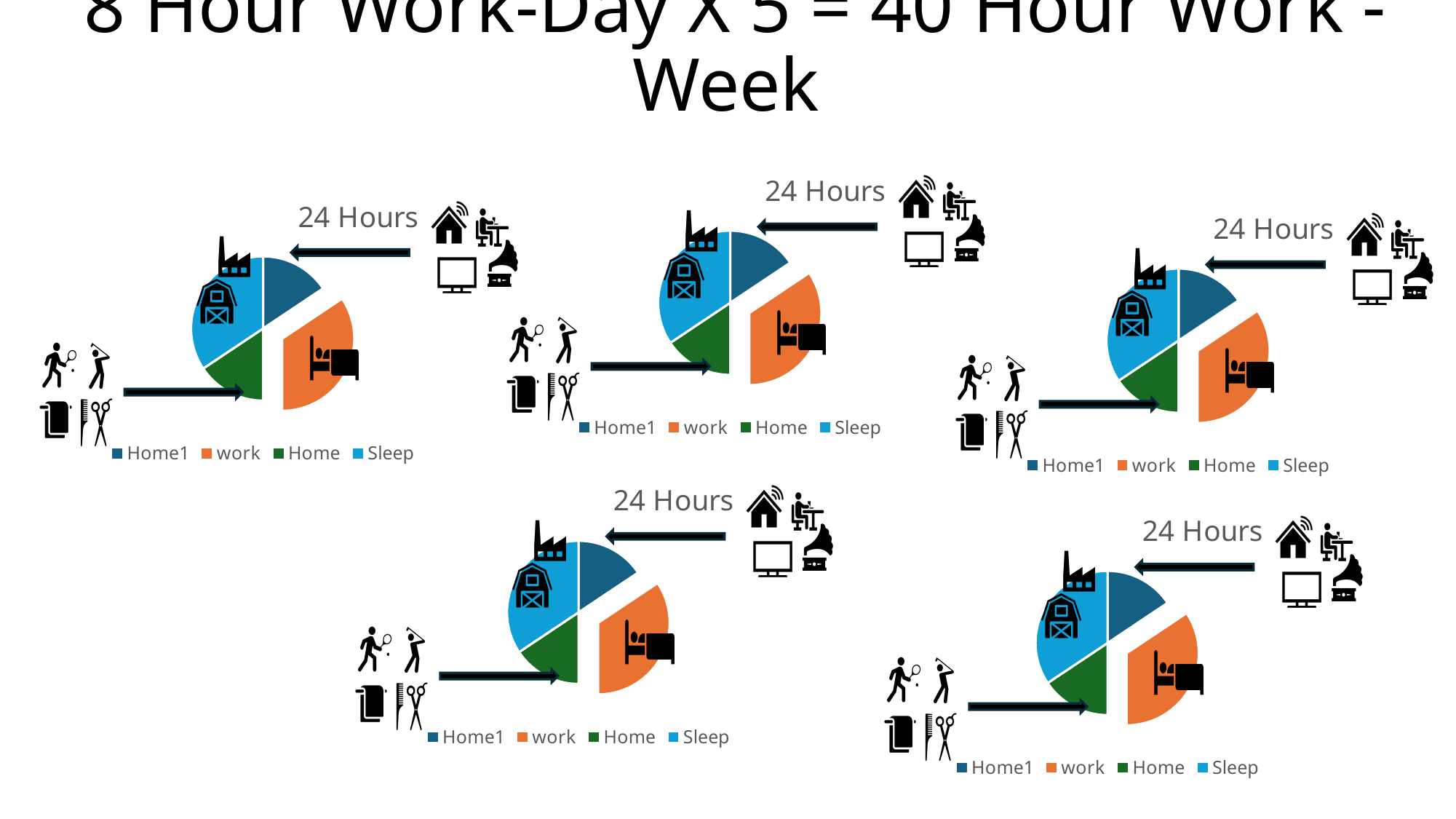
In the top-left pie chart, which slice is larger, work or Home? work Which legend entry is shown in orange in the top-middle pie chart? work In the top-middle pie chart, which slice is larger, Sleep or Home1? Sleep In the bottom-right pie chart, which slice is larger, Home or work? work How many slices does the bottom-right pie chart have? 4 How many pie charts are shown on the slide? 5 What kind of chart is the top-left chart on the slide? pie chart What total number of hours is labelled next to each pie chart? 24 Hours How many entries does the legend of the top-left pie chart list? 4